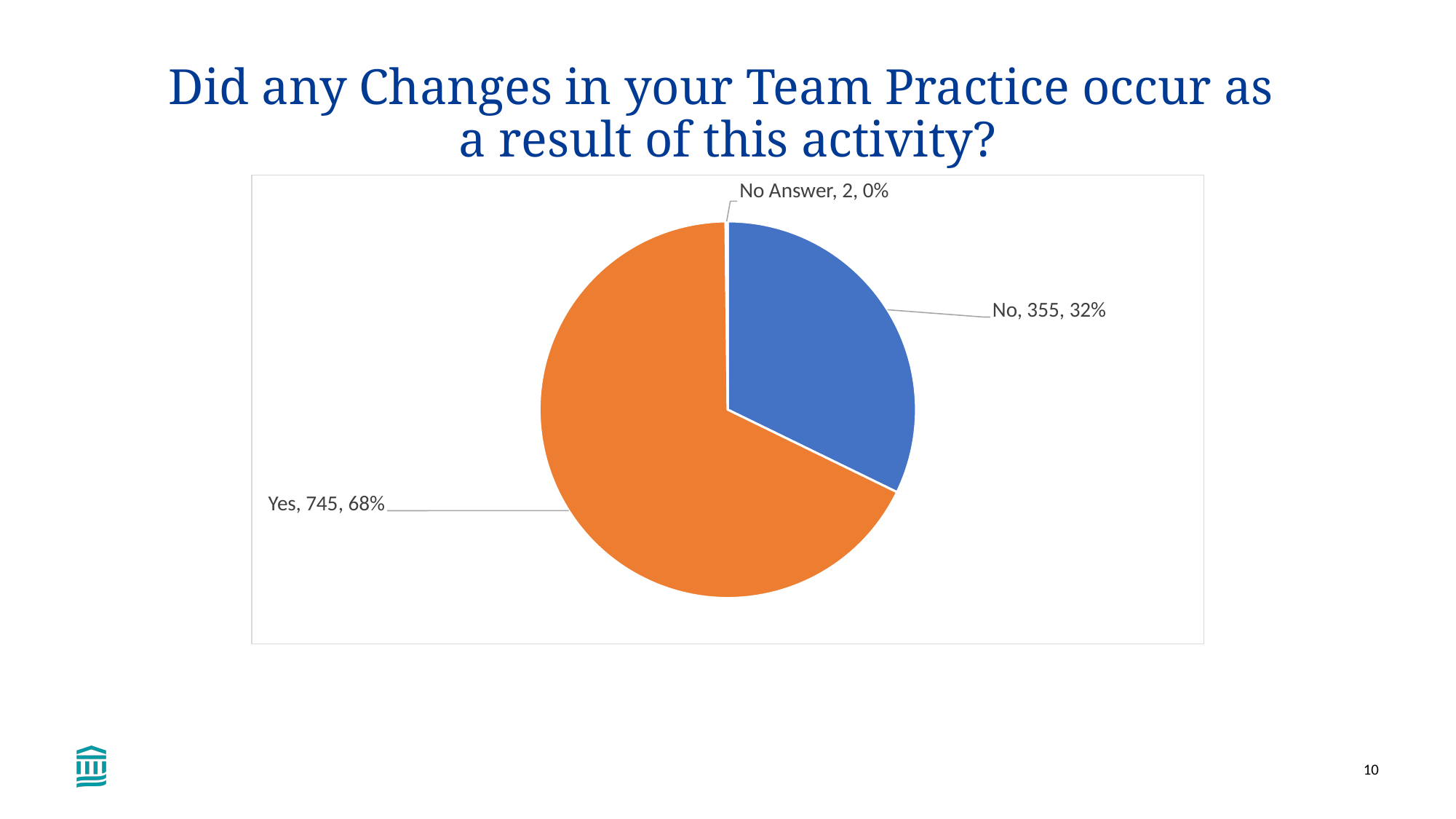
Which is larger, the Yes count or the No count? Yes What is the difference between the number of Yes and No responses? 390 Which category has the smallest slice? No Answer What share of the pie does the Yes slice represent? 68% How many respondents gave No Answer? 2 How many categories are shown in the pie chart? 3 What colour is the Yes slice? orange What share of the pie does the No slice represent? 32% What kind of chart is shown on the slide? pie chart How many respondents answered No? 355 How many respondents answered Yes? 745 Which category has the largest slice? Yes